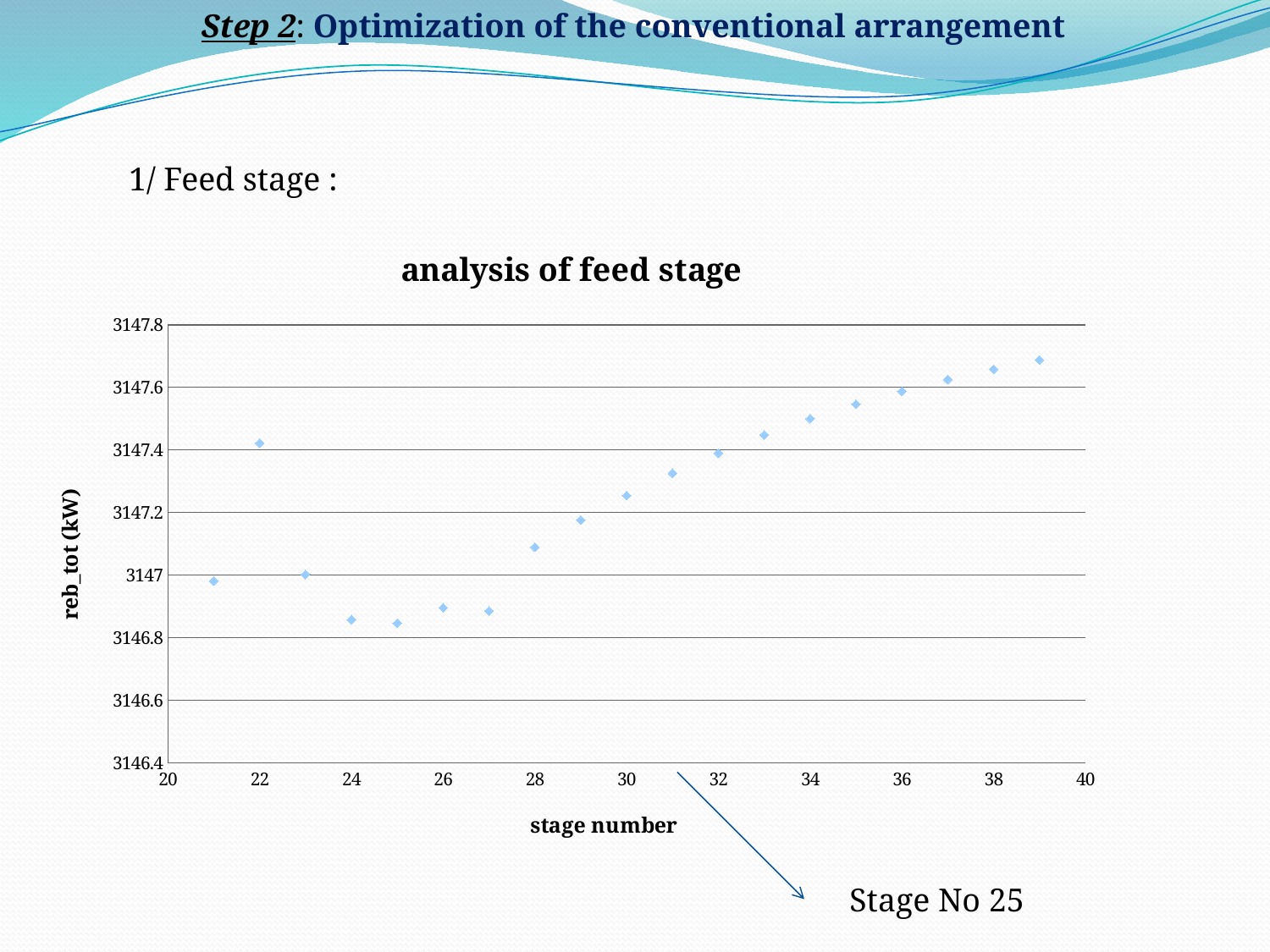
Is the value for stage number 39 greater or less than 3147.6? greater What is the title of the chart? analysis of feed stage Is the value for stage number 34 greater or less than 3147.4? greater Is the value for stage number 30 greater or less than 3147.2? greater From stage number 25 to stage number 39, do the values rise or fall? rise How many data points are plotted in the chart? 19 At which stage number is reb_tot (kW) lowest? 25 Which has a higher reb_tot value, stage number 22 or stage number 23? stage number 22 What kind of chart is shown on the slide? scatter chart At which stage number is reb_tot (kW) highest? 39 What is the label of the vertical axis of the chart? reb_tot (kW)